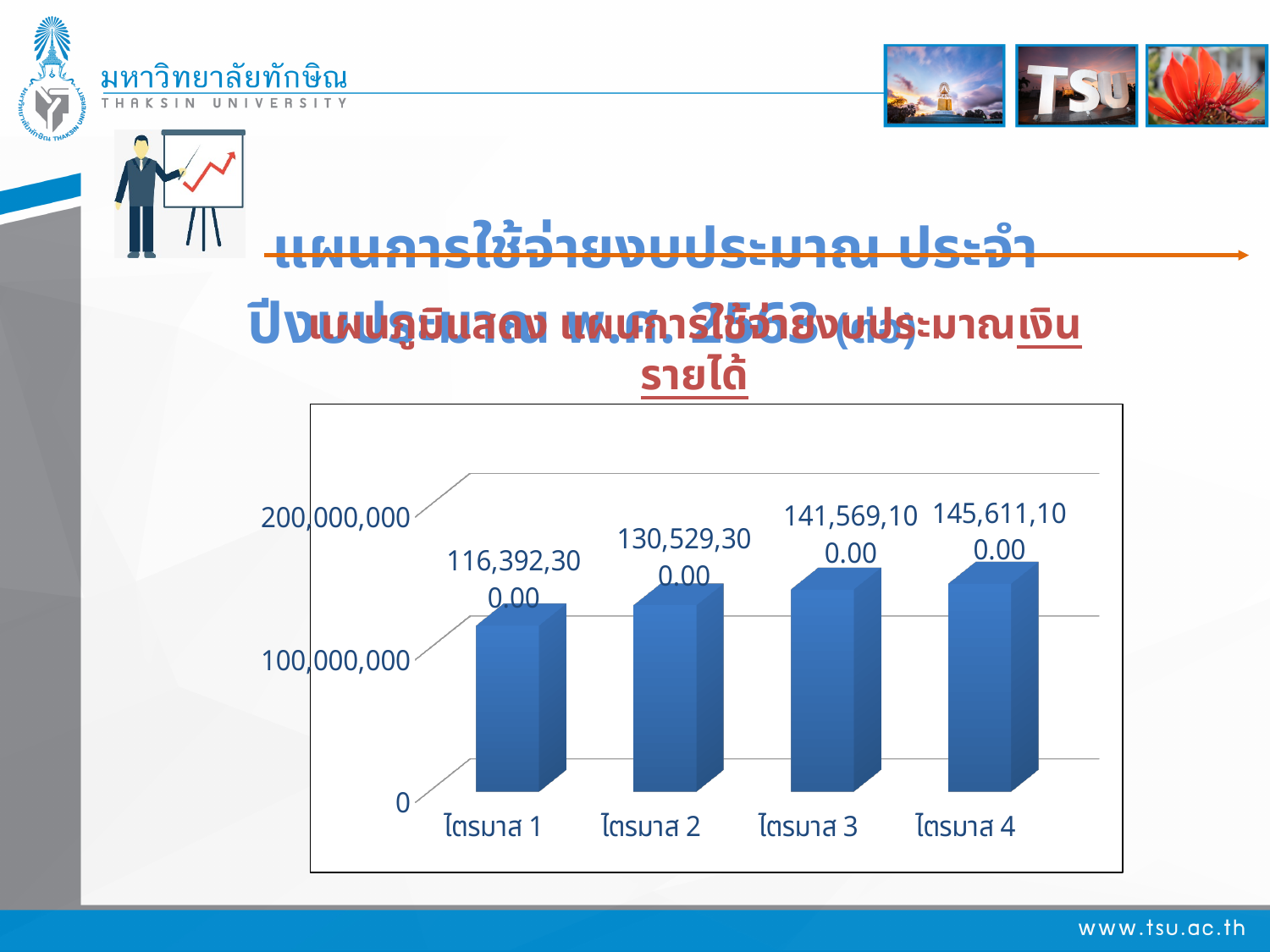
What is the value for ไตรมาส 3? 141,569,100.00 What is the value for ไตรมาส 4? 145,611,100.00 What kind of chart is shown on the slide? bar chart What is the difference between the values for ไตรมาส 4 and ไตรมาส 3? 4,042,000.00 Which quarter has the highest value? ไตรมาส 4 Is the value for ไตรมาส 1 greater or less than 100,000,000? greater What is the difference between the values for ไตรมาส 2 and ไตรมาส 1? 14,137,000.00 How many quarters are shown on the x axis? 4 Which is larger, the value for ไตรมาส 2 or the value for ไตรมาส 3? ไตรมาส 3 What is the value for ไตรมาส 2? 130,529,300.00 What is the value for ไตรมาส 1? 116,392,300.00 Which quarter has the lowest value? ไตรมาส 1